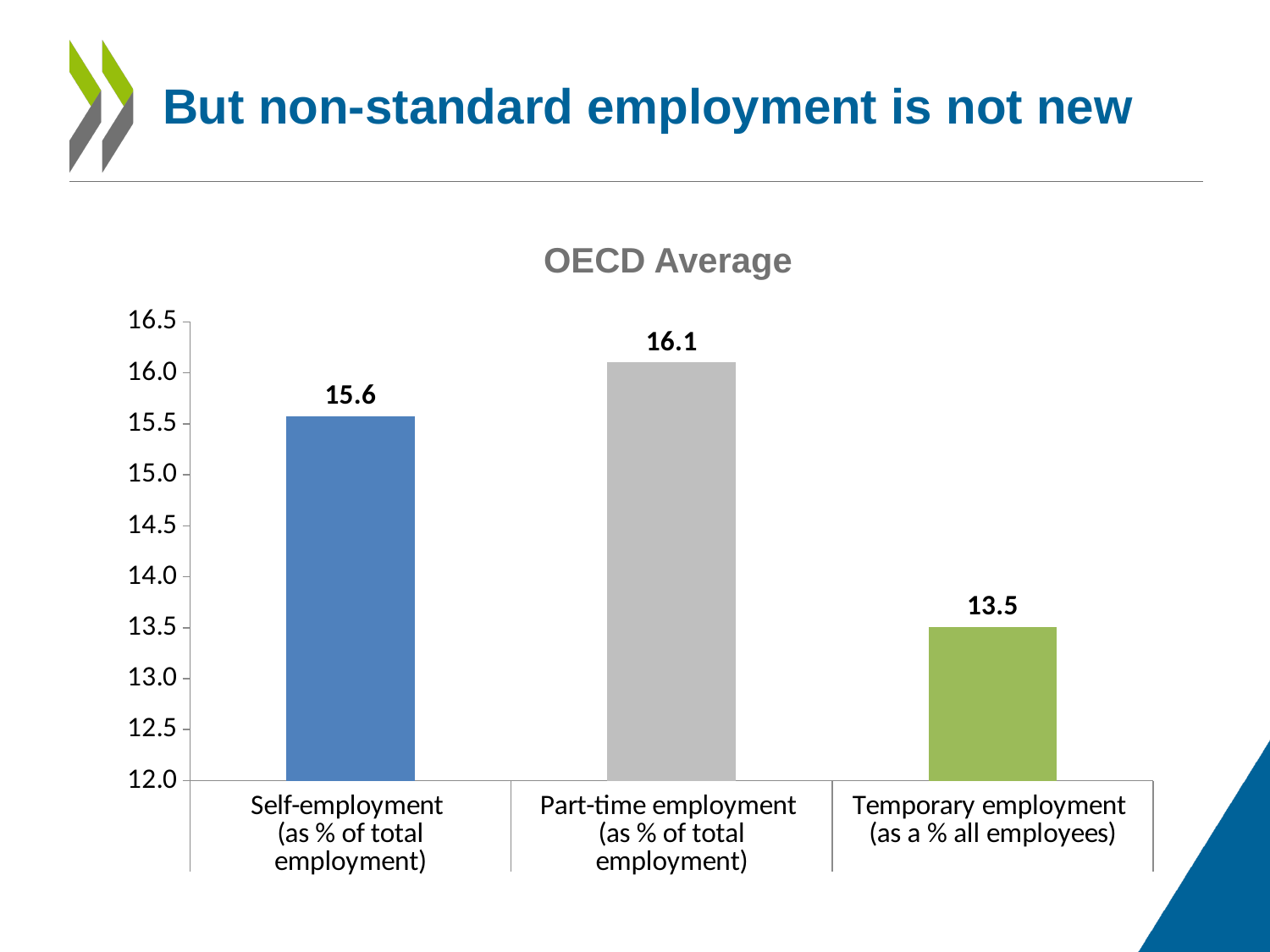
Which is larger, the value for Self-employment or the value for Temporary employment? Self-employment What is the value for Part-time employment (as % of total employment)? 16.1 What is the value for Self-employment (as % of total employment)? 15.6 What is the difference between the values for Self-employment and Temporary employment? 2.1 How many categories are shown in the chart? 3 What is the difference between the values for Part-time employment and Self-employment? 0.5 What is the value for Temporary employment (as a % all employees)? 13.5 Which category has the lowest value? Temporary employment (as a % all employees) Is the value for Temporary employment greater or less than 14.0? less What kind of chart is shown on the slide? bar chart Which category has the highest value? Part-time employment (as % of total employment) What is the title of the chart? OECD Average